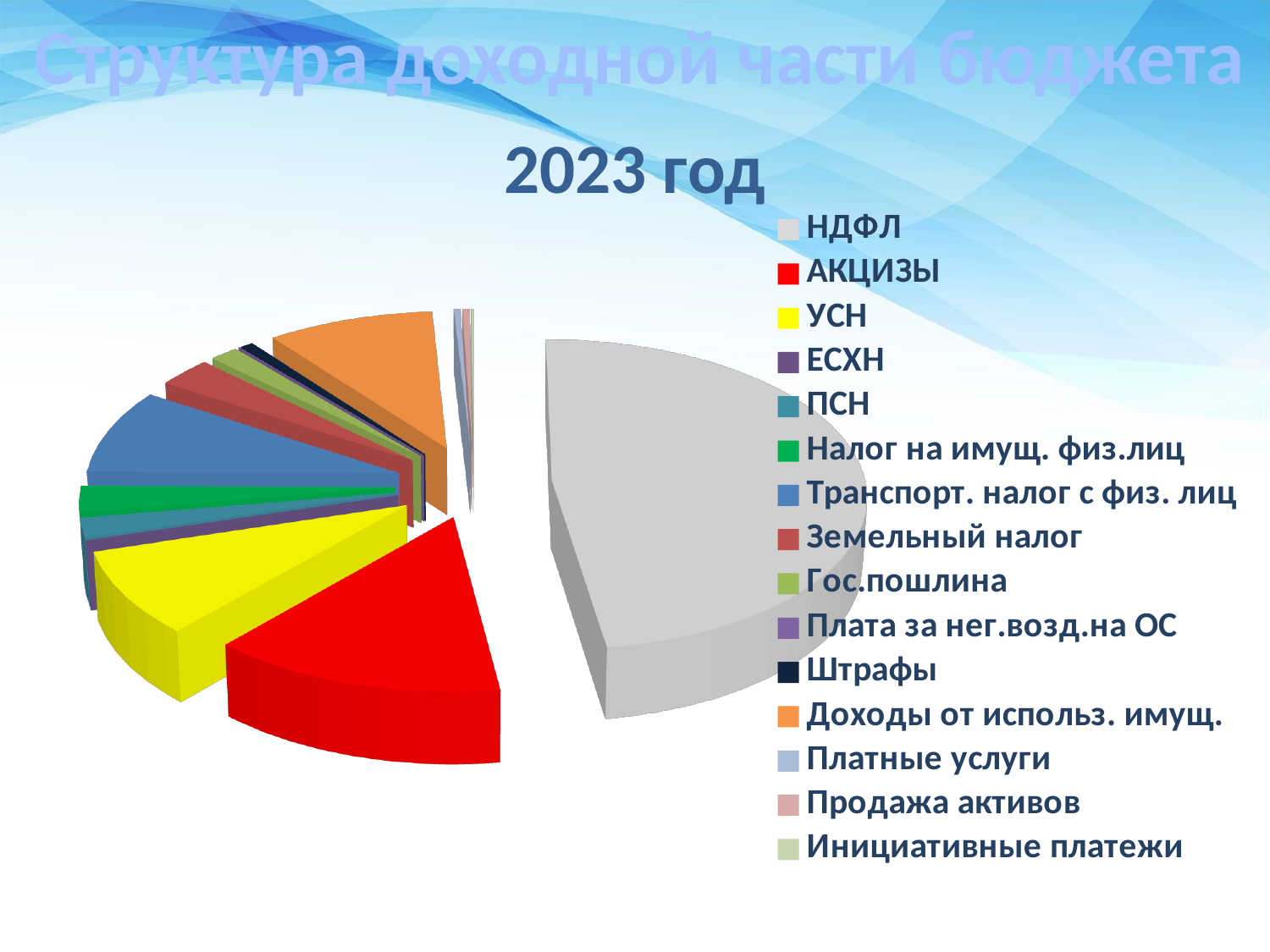
How many categories does the legend of the pie chart list? 15 Which category has the largest slice of the pie chart? НДФЛ Which slice is larger, Транспорт. налог с физ. лиц or Земельный налог? Транспорт. налог с физ. лиц Which slice is larger, Доходы от использ. имущ. or Гос.пошлина? Доходы от использ. имущ. Which slice is larger, УСН or Налог на имущ. физ.лиц? УСН What kind of chart is shown on the slide? pie chart Which year does the chart on the slide refer to? 2023 год What colour is the АКЦИЗЫ slice in the pie chart? red